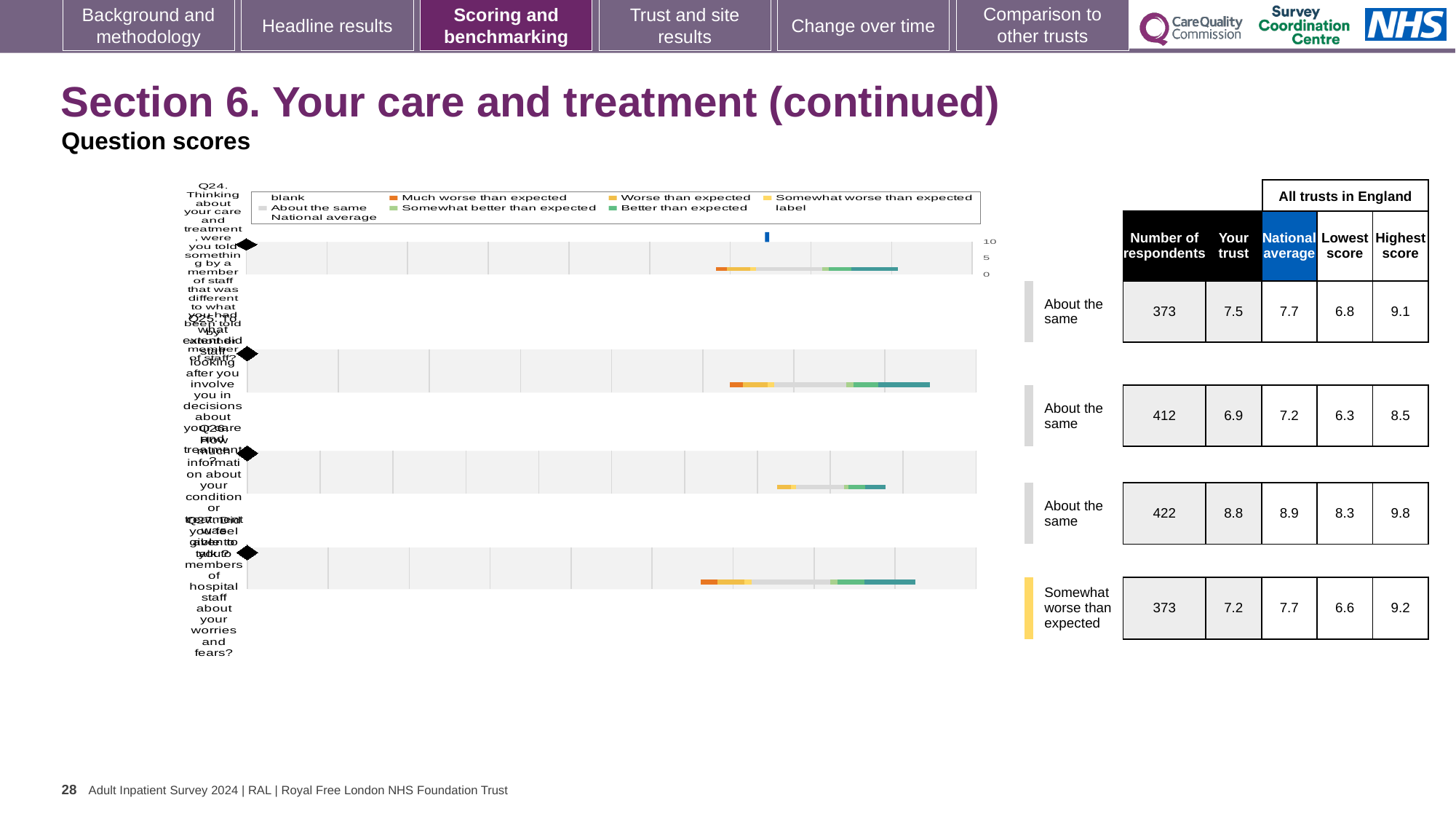
What kind of chart is used to show the Q24 benchmarking result? bar chart In the table beside the charts, which row has the highest 'Highest score' value? the third row (9.8) How many entries does the legend above the charts list? 9 In the table beside the charts, is the 'Your trust' score in the second row larger or smaller than its national average? smaller What colour represents 'About the same' in the legend? grey In the table beside the charts, what is the national average in the row labelled 'Somewhat worse than expected'? 7.7 In the table beside the charts, what is the difference between the highest score and lowest score in the third row? 1.5 In the table beside the charts, what is the number of respondents in the row labelled 'Somewhat worse than expected'? 373 What is the highest tick value shown on the axis of the first chart? 10 In the table beside the charts, what is the 'Your trust' score in the row labelled 'Somewhat worse than expected'? 7.2 How many benchmarking charts are shown on the slide? 4 What colour represents 'Much worse than expected' in the legend? orange